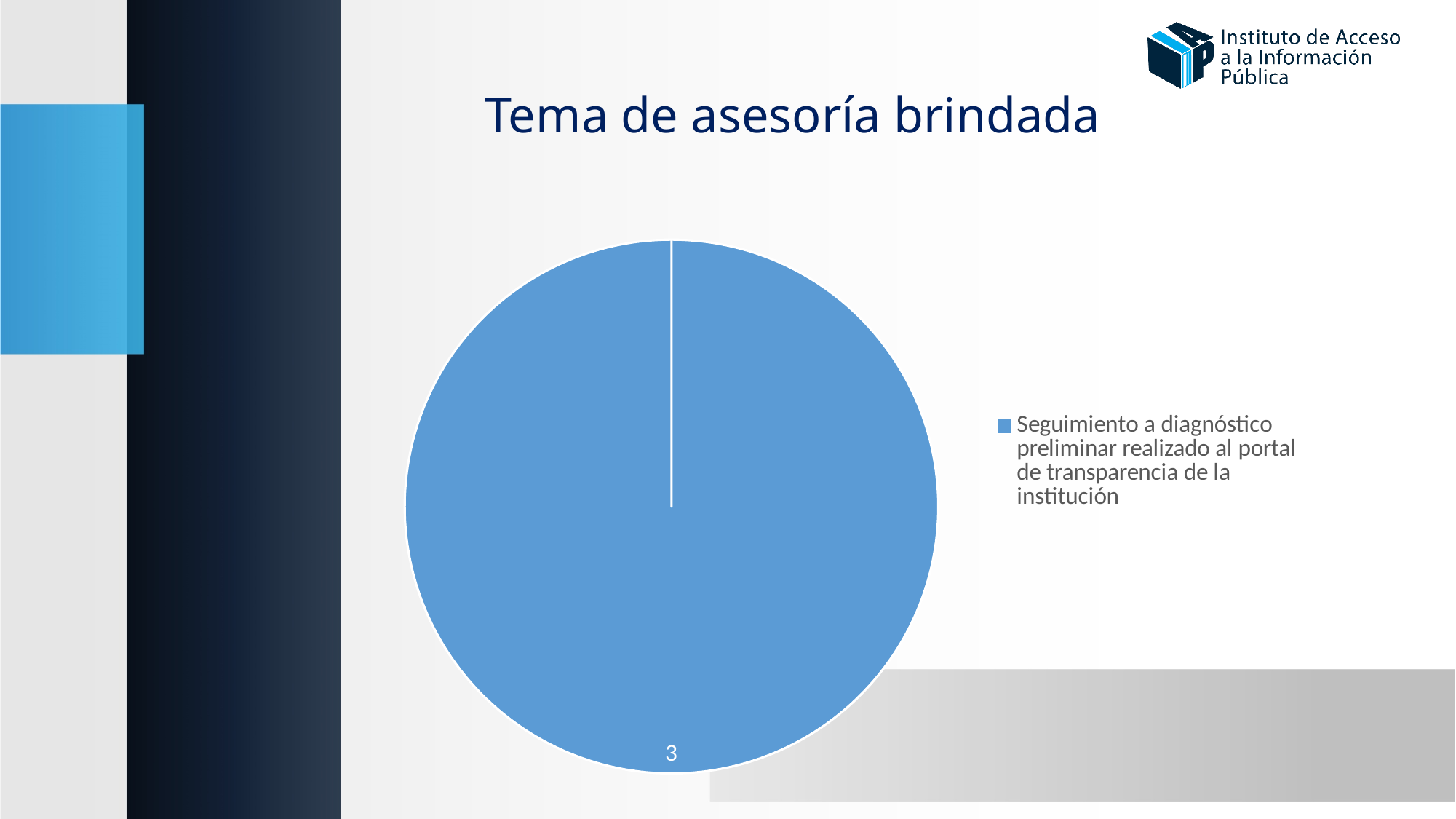
Which category is the largest in the pie chart? Seguimiento a diagnóstico preliminar realizado al portal de transparencia de la institución What value is shown for the slice 'Seguimiento a diagnóstico preliminar realizado al portal de transparencia de la institución'? 3 What share of the pie does the slice 'Seguimiento a diagnóstico preliminar realizado al portal de transparencia de la institución' represent? 100% What kind of chart is shown on the slide? pie chart How many entries does the legend of the pie chart list? 1 What is the title of the chart on the slide? Tema de asesoría brindada What colour is the slice of the pie chart? blue What is the total of all values shown in the pie chart? 3 How many slices does the pie chart have? 1